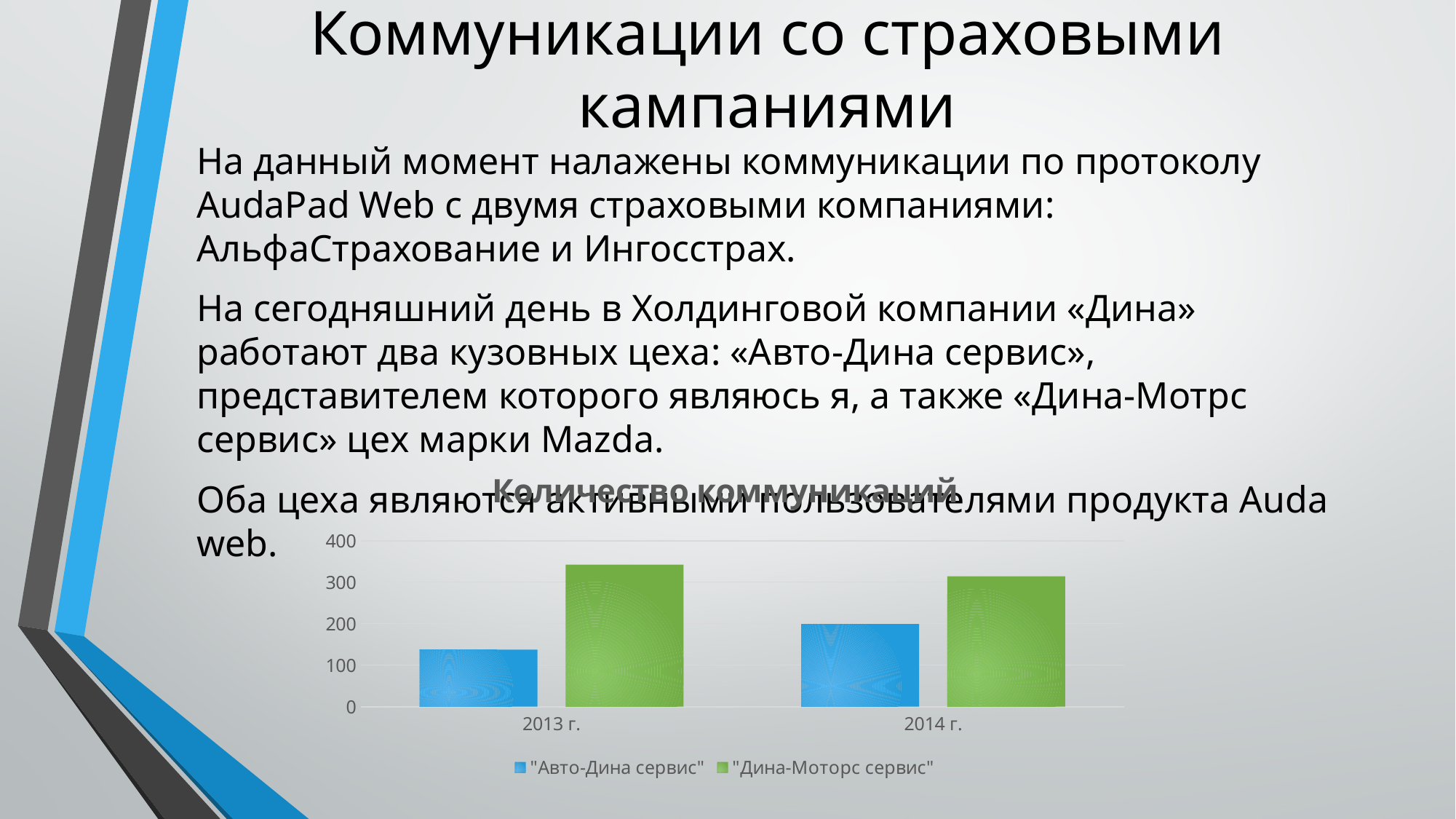
Which series is shown in green in the chart? "Дина-Моторс сервис" How many categories are shown on the x axis of the chart? 2 In 2013 г., which series has the larger value, "Авто-Дина сервис" or "Дина-Моторс сервис"? "Дина-Моторс сервис" Does the value for "Авто-Дина сервис" rise or fall from 2013 г. to 2014 г.? rise How many series does the chart legend list? 2 Is the value for "Авто-Дина сервис" in 2013 г. greater or less than 100? greater What is the title of the chart? Количество коммуникаций Is the value for "Дина-Моторс сервис" in 2014 г. greater or less than 400? less In 2014 г., which series has the larger value, "Авто-Дина сервис" or "Дина-Моторс сервис"? "Дина-Моторс сервис" What kind of chart is shown on the slide? bar chart Is the value for "Дина-Моторс сервис" in 2013 г. greater or less than 300? greater